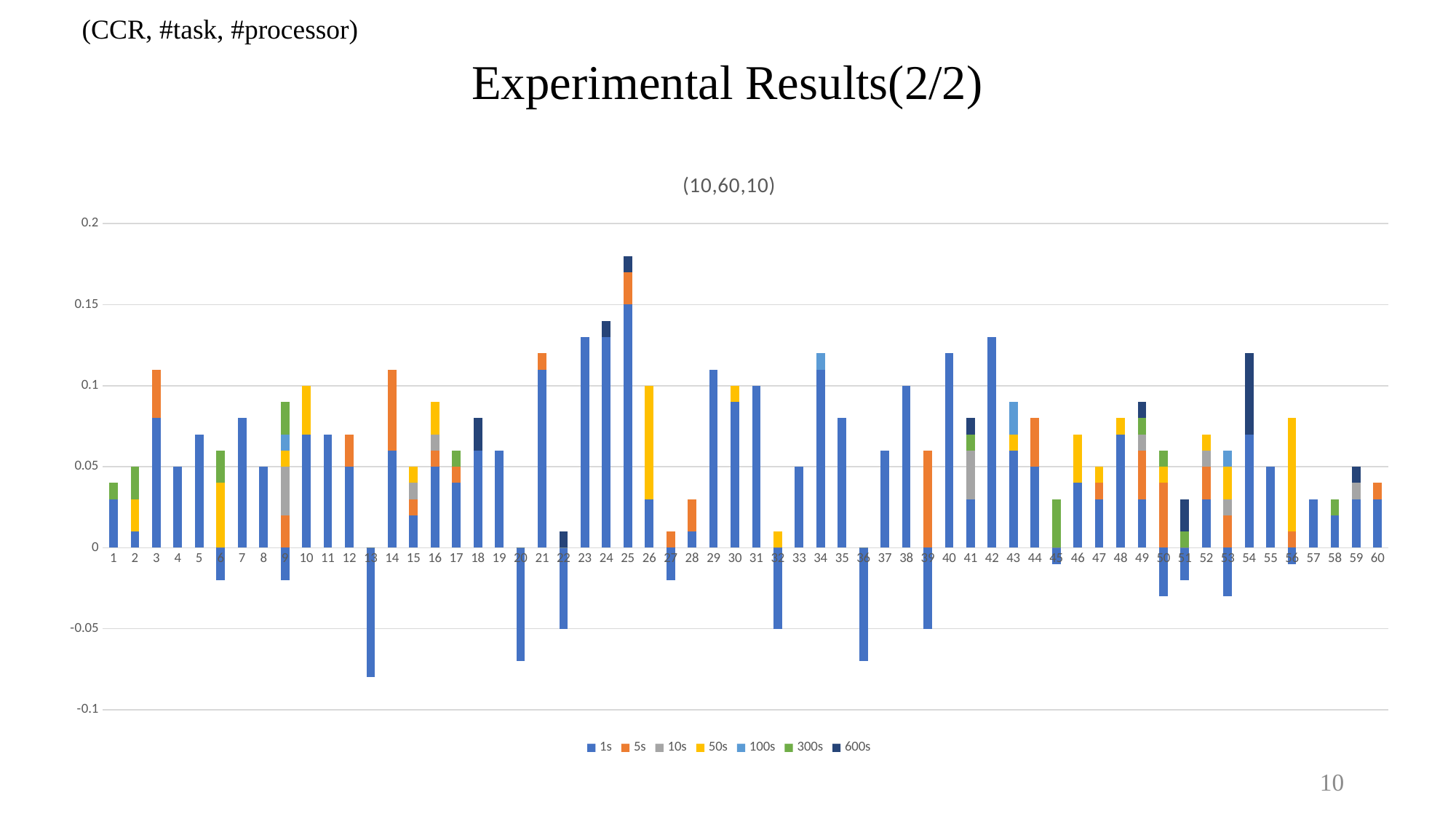
How many categories are shown along the x axis? 60 Which series is shown in yellow in the legend? 50s Is the value for category 13 greater or less than -0.05? less How many series does the legend list? 7 Is the total value for category 25 greater or less than 0.15? greater What is the value for category 31? 0.1 What is the value for category 55? 0.05 What kind of chart is shown on the slide? Stacked bar chart Which category has the highest stacked bar? 25 What is the title of the chart? (10,60,10) Is the total value for category 3 greater or less than 0.1? greater Which is larger, the bar for category 23 or the bar for category 3? 23